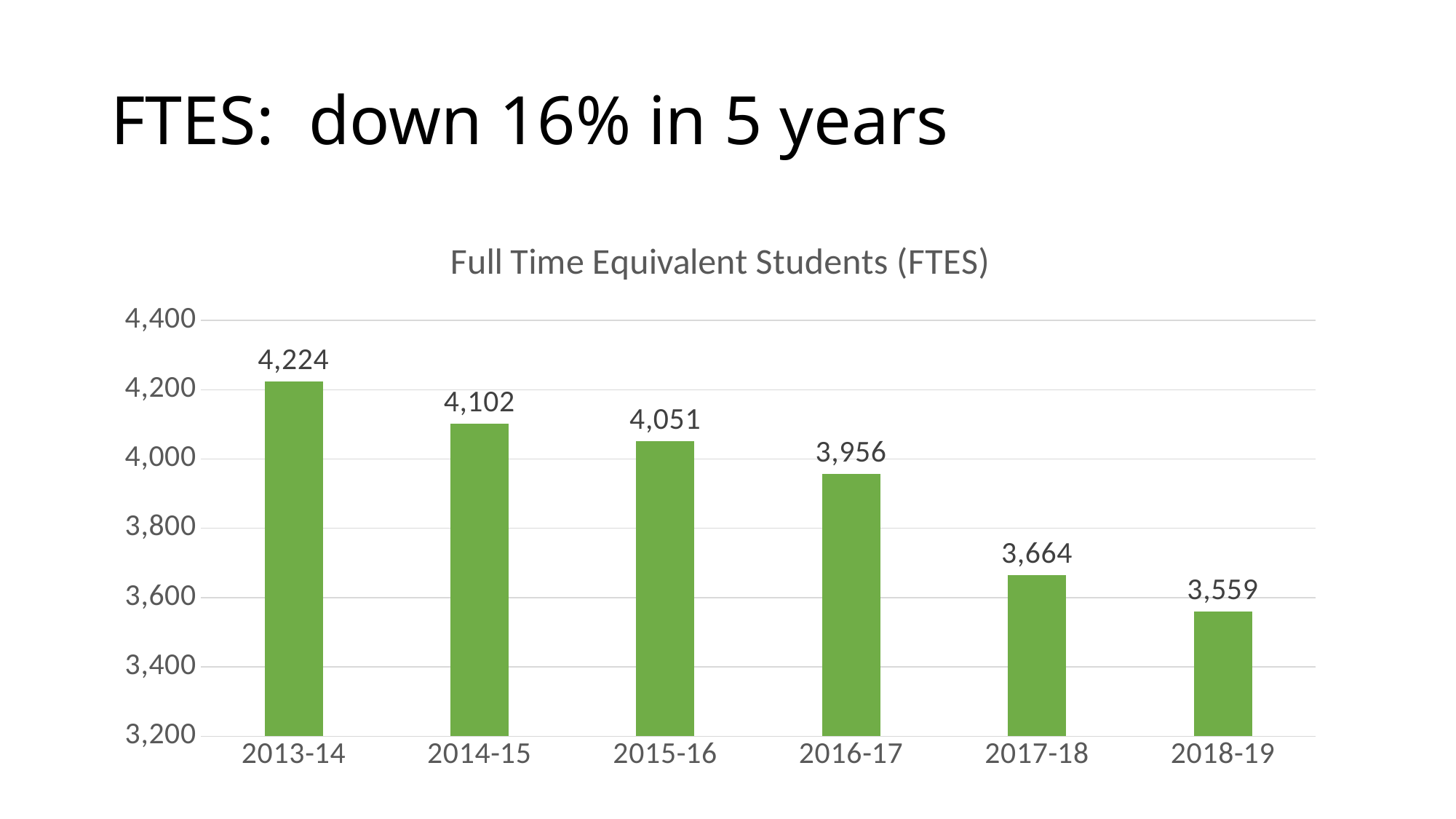
How many years are shown on the chart? 6 What is the difference in FTES between 2013-14 and 2018-19? 665 Which year has the highest FTES? 2013-14 Do the FTES values rise or fall from 2013-14 to 2018-19? fall What kind of chart is shown on the slide? bar chart What is the FTES value for 2016-17? 3,956 Which year has the lowest FTES? 2018-19 Which year has a larger FTES value, 2014-15 or 2015-16? 2014-15 What is the FTES value for 2013-14? 4,224 What is the FTES value for 2018-19? 3,559 Is the FTES value for 2017-18 greater or less than 3,800? less What is the difference in FTES between 2016-17 and 2017-18? 292